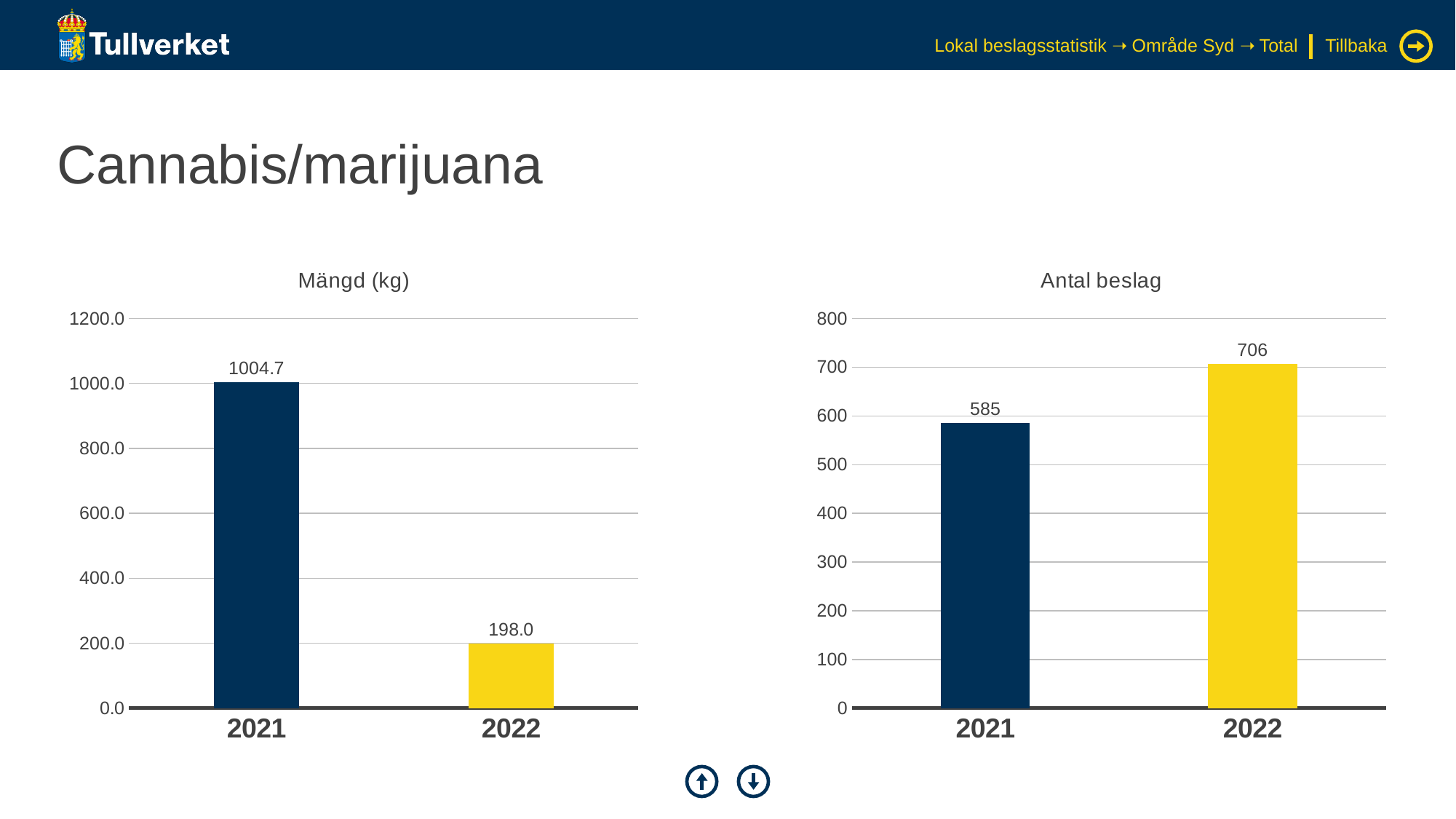
What kind of chart is the 'Mängd (kg)' chart? bar chart How many categories are shown on the x axis of the 'Antal beslag' chart? 2 In the 'Mängd (kg)' chart, what is the difference between the 2021 and 2022 values? 806.7 In the 'Mängd (kg)' chart, what is the value for 2021? 1004.7 In the 'Mängd (kg)' chart, which year has the highest value? 2021 In the 'Antal beslag' chart, what is the value for 2022? 706 In the 'Antal beslag' chart, which year has the lowest value? 2021 In the 'Antal beslag' chart, what is the value for 2021? 585 In the 'Antal beslag' chart, which is larger, the value for 2021 or 2022? 2022 In the 'Antal beslag' chart, what is the difference between the 2022 and 2021 values? 121 In the 'Mängd (kg)' chart, do the values rise or fall from 2021 to 2022? fall In the 'Mängd (kg)' chart, what is the value for 2022? 198.0